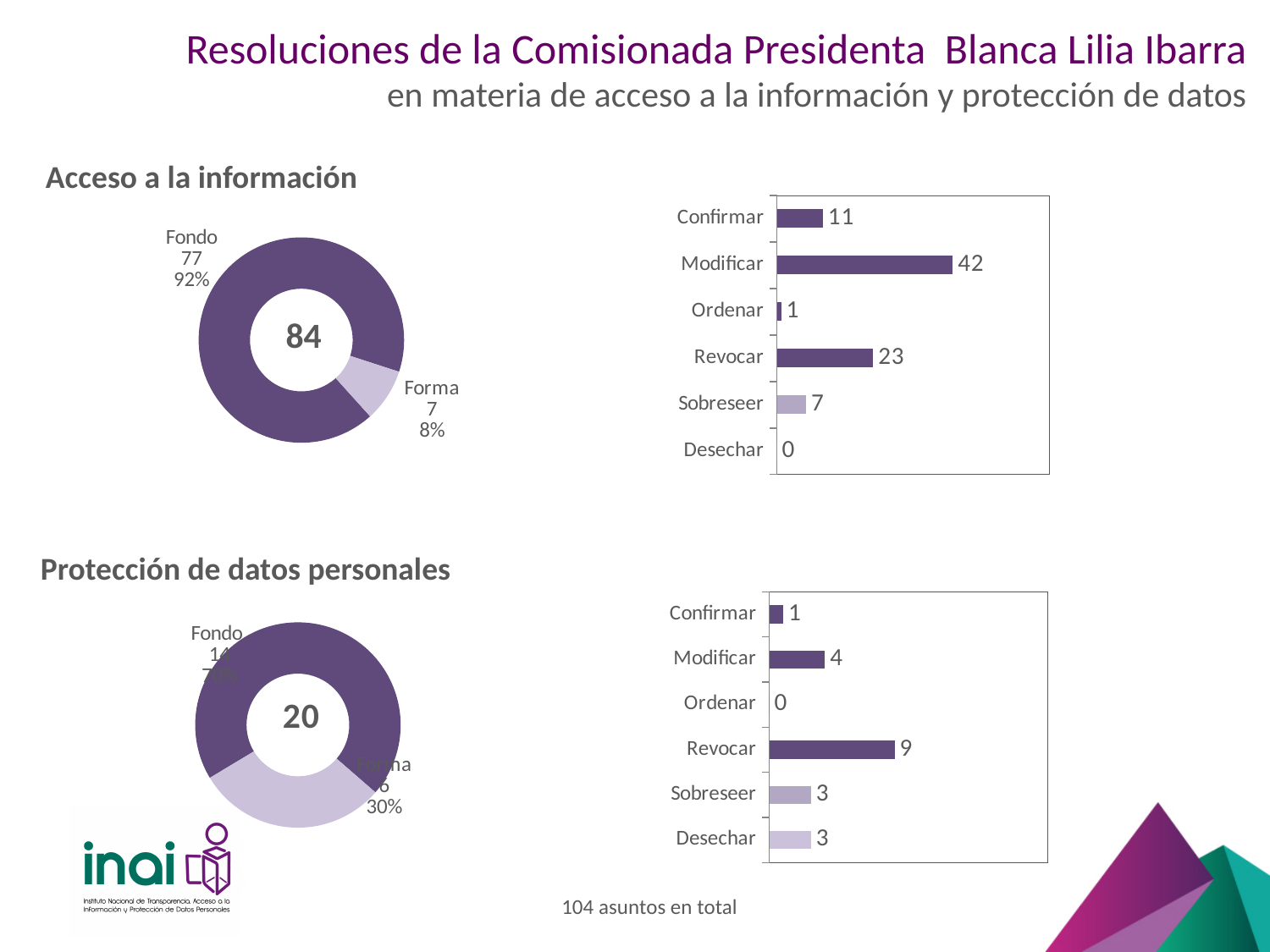
In the Acceso a la información bar chart, which category has the highest value? Modificar In the Acceso a la información bar chart, how many categories are shown? 6 In the Protección de datos personales bar chart, which category has the highest value? Revocar In the Acceso a la información donut chart, what is the value for Forma? 7 What kind of chart is the one on the top right of the slide? Bar chart In the Acceso a la información bar chart, what is the difference between Modificar and Revocar? 19 In the Protección de datos personales bar chart, which is larger, Modificar or Sobreseer? Modificar In the Acceso a la información bar chart, what is the value for Modificar? 42 In the Acceso a la información bar chart, which category has the lowest value? Desechar In the Protección de datos personales bar chart, what is the value for Revocar? 9 In the Acceso a la información donut chart, what share does Fondo represent? 92% What total is shown in the centre of the Acceso a la información donut chart? 84